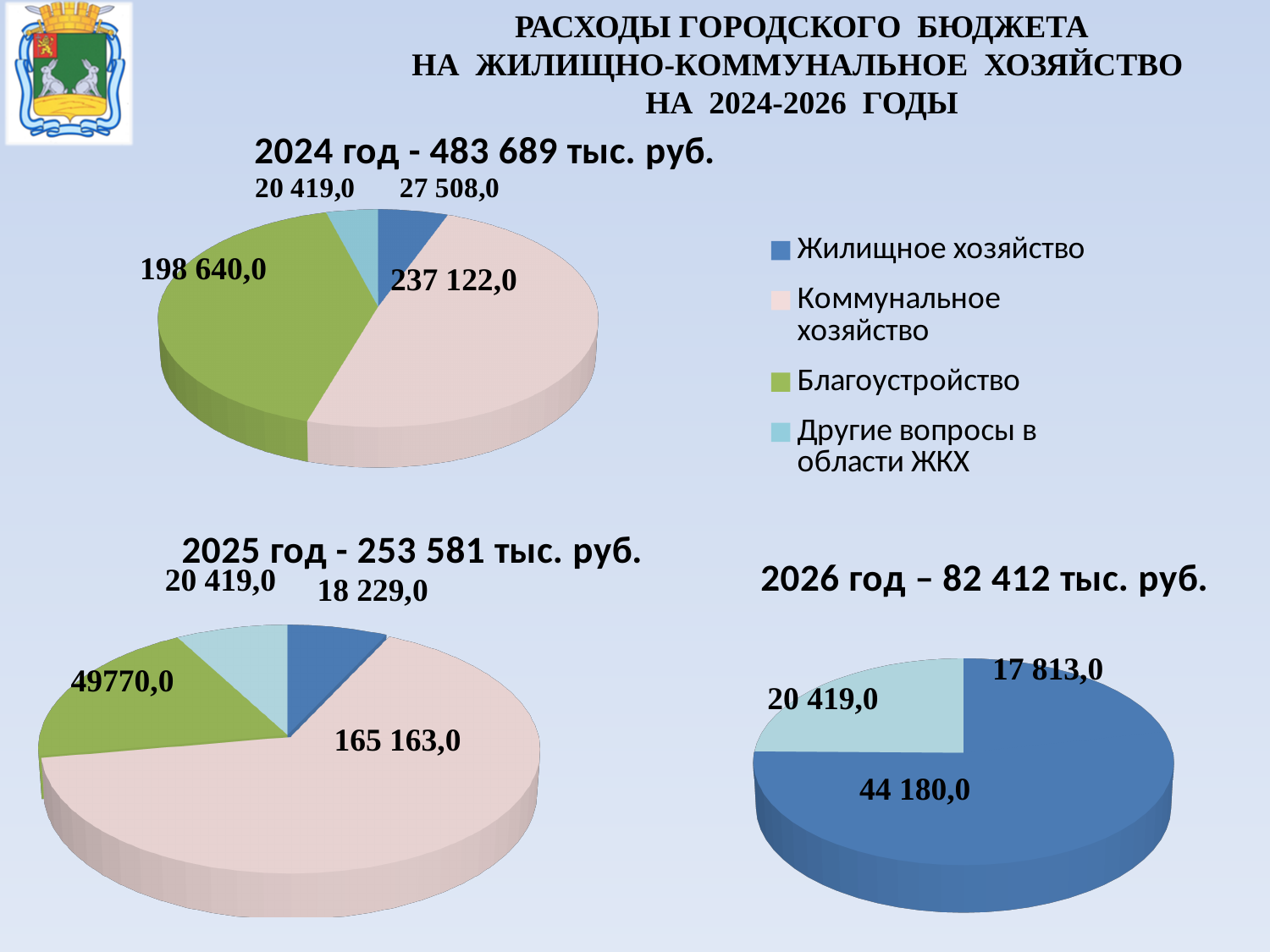
On the 2024 pie chart, what is the value for Благоустройство? 198 640,0 What is the total for 2026 stated above the 2026 pie chart? 82 412 тыс. руб. On the 2025 pie chart, which category has the largest slice? Коммунальное хозяйство On the 2024 pie chart, what is the value for Коммунальное хозяйство? 237 122,0 How many categories does the legend list? 4 What type of chart is used on this slide? Pie chart On the 2026 pie chart, what is the largest value shown? 44 180,0 On the 2024 pie chart, what is the difference between Коммунальное хозяйство and Благоустройство? 38 482,0 How many pie charts are on the slide? 3 On the 2025 pie chart, what is the value for Жилищное хозяйство? 18 229,0 On the 2024 pie chart, which category has the smallest slice? Другие вопросы в области ЖКХ On the 2025 pie chart, which is larger: Благоустройство or Другие вопросы в области ЖКХ? Благоустройство